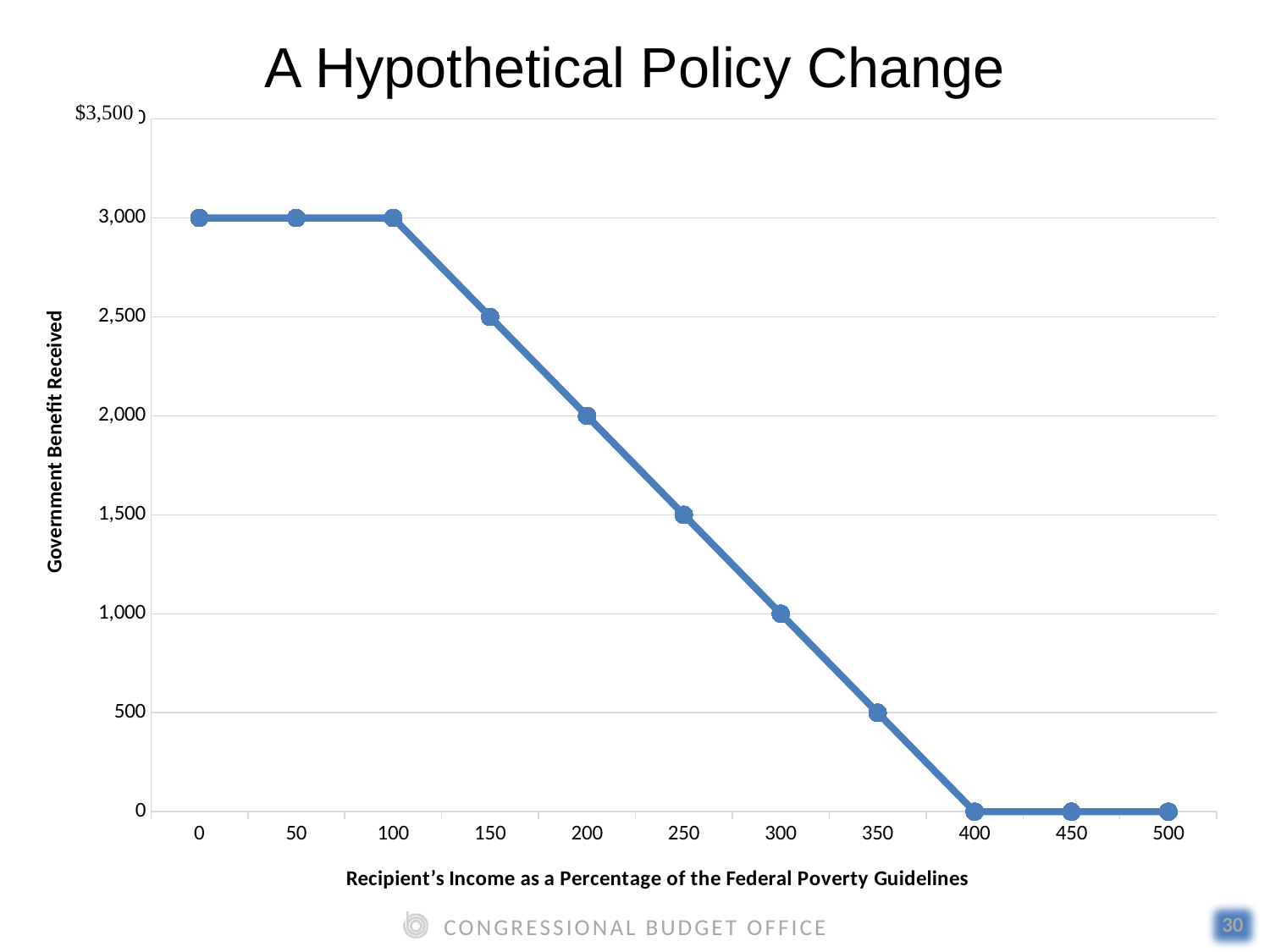
What is the label of the x axis? Recipient's Income as a Percentage of the Federal Poverty Guidelines What is the government benefit received when the recipient's income is 150 percent of the federal poverty guidelines? 2,500 What is the government benefit received when the recipient's income is 300 percent of the federal poverty guidelines? 1,000 How many data points are plotted on the line? 11 What is the difference between the benefit at 200 percent and the benefit at 350 percent of the federal poverty guidelines? 1,500 What is the government benefit received when the recipient's income is 50 percent of the federal poverty guidelines? 3,000 Which is larger, the benefit at 250 percent or the benefit at 300 percent of the federal poverty guidelines? 250 percent What is the government benefit received when the recipient's income is 400 percent of the federal poverty guidelines? 0 What is the title of the chart? A Hypothetical Policy Change What type of chart is shown on the slide? line chart What is the highest government benefit value plotted on the chart? 3,000 Does the government benefit received rise or fall as income moves from 100 to 400 percent of the federal poverty guidelines? fall